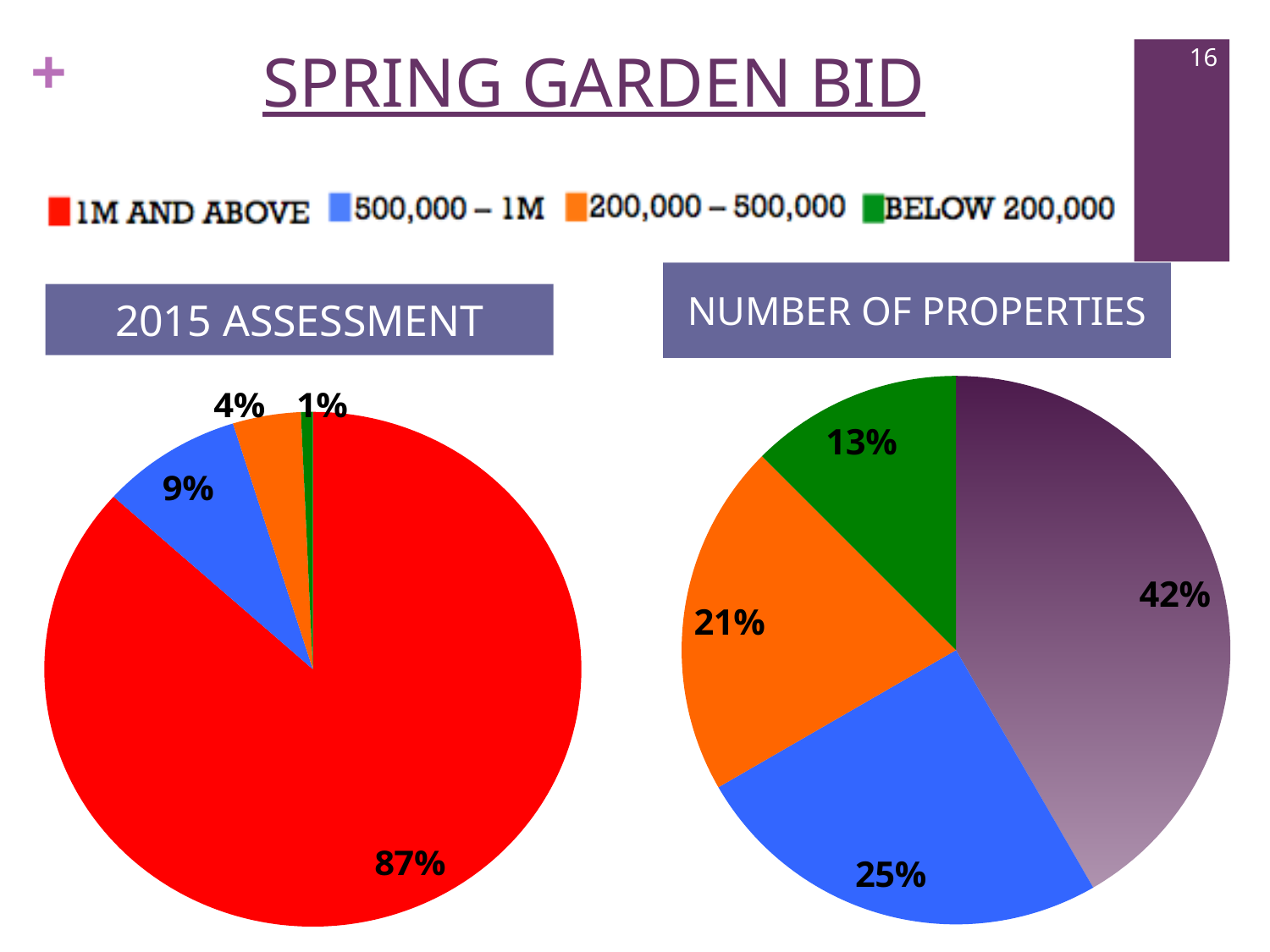
In the NUMBER OF PROPERTIES chart, what share is shown for 500,000 – 1M? 25% In the 2015 ASSESSMENT chart, what share is shown for 1M AND ABOVE? 87% In the 2015 ASSESSMENT chart, what is the difference between the 500,000 – 1M share and the 200,000 – 500,000 share? 5% In the NUMBER OF PROPERTIES chart, what share is shown for 200,000 – 500,000? 21% How many categories does the legend list? 4 In the 2015 ASSESSMENT chart, which category has the smallest slice? BELOW 200,000 What kind of chart is the 2015 ASSESSMENT chart? pie chart In the NUMBER OF PROPERTIES chart, what is the share of the largest slice? 42% In the NUMBER OF PROPERTIES chart, which is larger: the 500,000 – 1M slice or the BELOW 200,000 slice? 500,000 – 1M